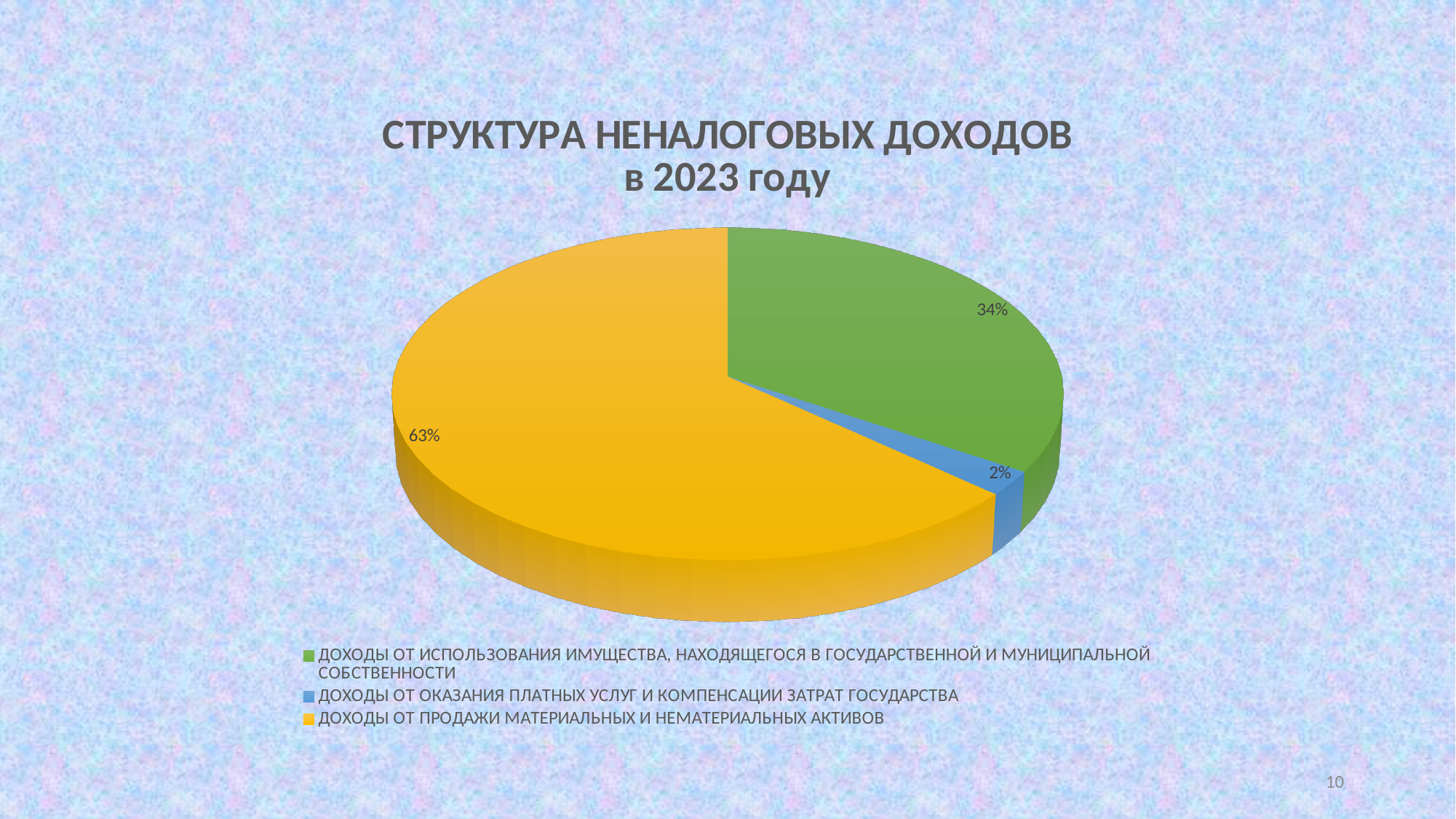
What share of the pie is ДОХОДЫ ОТ ОКАЗАНИЯ ПЛАТНЫХ УСЛУГ И КОМПЕНСАЦИИ ЗАТРАТ ГОСУДАРСТВА? 2% Which is larger: the share of ДОХОДЫ ОТ ИСПОЛЬЗОВАНИЯ ИМУЩЕСТВА, НАХОДЯЩЕГОСЯ В ГОСУДАРСТВЕННОЙ И МУНИЦИПАЛЬНОЙ СОБСТВЕННОСТИ or the share of ДОХОДЫ ОТ ОКАЗАНИЯ ПЛАТНЫХ УСЛУГ И КОМПЕНСАЦИИ ЗАТРАТ ГОСУДАРСТВА? ДОХОДЫ ОТ ИСПОЛЬЗОВАНИЯ ИМУЩЕСТВА, НАХОДЯЩЕГОСЯ В ГОСУДАРСТВЕННОЙ И МУНИЦИПАЛЬНОЙ СОБСТВЕННОСТИ How many entries does the legend list? 3 What share of the pie is ДОХОДЫ ОТ ПРОДАЖИ МАТЕРИАЛЬНЫХ И НЕМАТЕРИАЛЬНЫХ АКТИВОВ? 63% How many slices does the pie chart have? 3 What is the title of the chart? СТРУКТУРА НЕНАЛОГОВЫХ ДОХОДОВ в 2023 году What is the difference in percentage points between the share of ДОХОДЫ ОТ ПРОДАЖИ МАТЕРИАЛЬНЫХ И НЕМАТЕРИАЛЬНЫХ АКТИВОВ and the share of ДОХОДЫ ОТ ИСПОЛЬЗОВАНИЯ ИМУЩЕСТВА, НАХОДЯЩЕГОСЯ В ГОСУДАРСТВЕННОЙ И МУНИЦИПАЛЬНОЙ СОБСТВЕННОСТИ? 29% Which category has the largest share of the pie? ДОХОДЫ ОТ ПРОДАЖИ МАТЕРИАЛЬНЫХ И НЕМАТЕРИАЛЬНЫХ АКТИВОВ Which category has the smallest share of the pie? ДОХОДЫ ОТ ОКАЗАНИЯ ПЛАТНЫХ УСЛУГ И КОМПЕНСАЦИИ ЗАТРАТ ГОСУДАРСТВА What share of the pie is ДОХОДЫ ОТ ИСПОЛЬЗОВАНИЯ ИМУЩЕСТВА, НАХОДЯЩЕГОСЯ В ГОСУДАРСТВЕННОЙ И МУНИЦИПАЛЬНОЙ СОБСТВЕННОСТИ? 34% What colour is the slice for ДОХОДЫ ОТ ПРОДАЖИ МАТЕРИАЛЬНЫХ И НЕМАТЕРИАЛЬНЫХ АКТИВОВ? Yellow What type of chart is shown on the slide? Pie chart